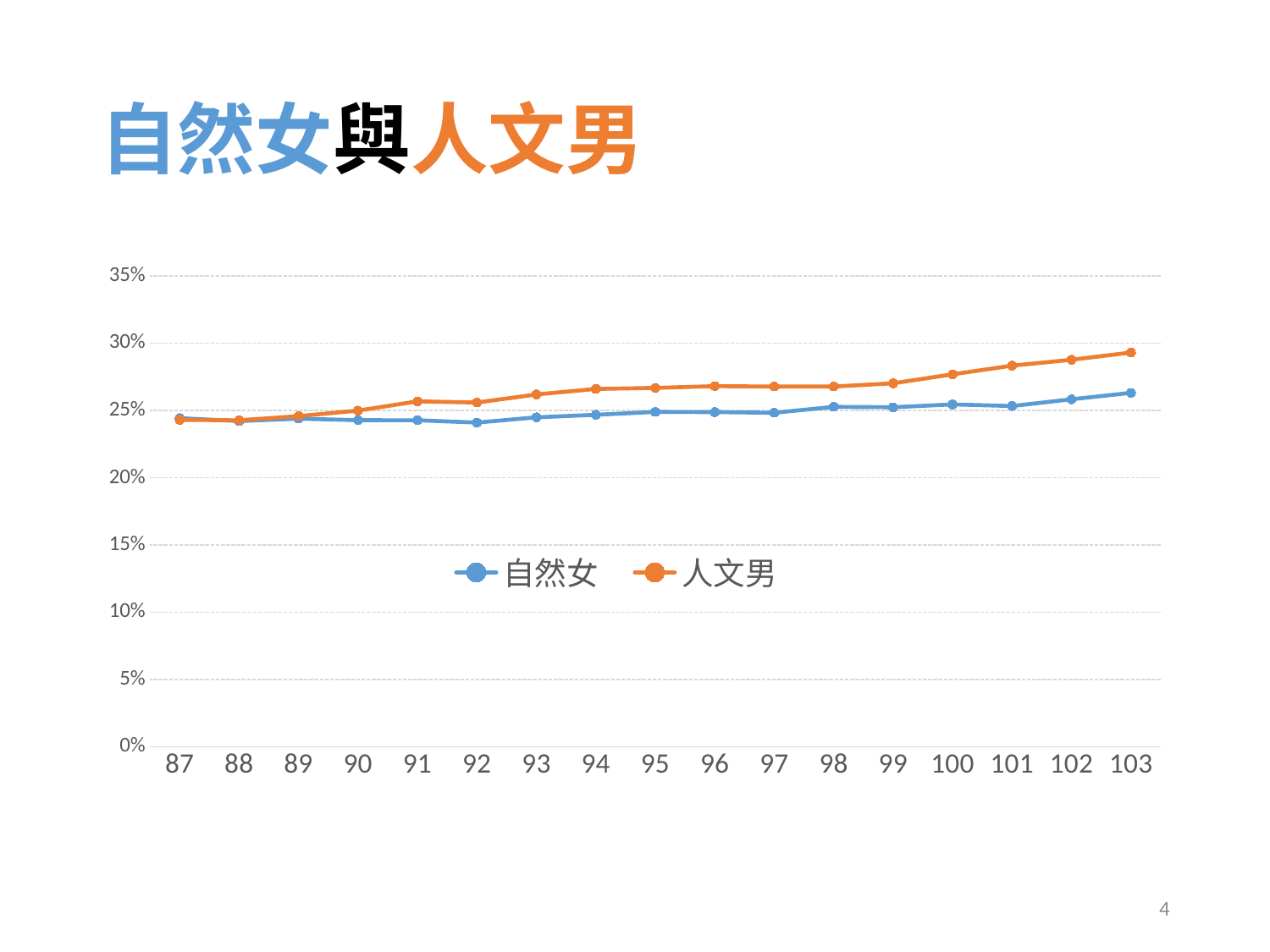
What kind of chart is shown on the slide? line chart Does the 自然女 series generally rise or fall from 87 to 103? rise Is the value for 人文男 at 103 greater or less than 30%? less At 103, which series has the higher value, 自然女 or 人文男? 人文男 At which x-axis value does the 自然女 series reach its highest point? 103 What are the two series named in the legend? 自然女 and 人文男 How many series does the legend list? 2 Which colour is used for the 人文男 series? orange Is the value for 自然女 at 103 greater or less than 25%? greater At which x-axis value does the 人文男 series reach its highest point? 103 How many points are plotted along the x axis for each series? 17 Does the 人文男 series generally rise or fall from 87 to 103? rise